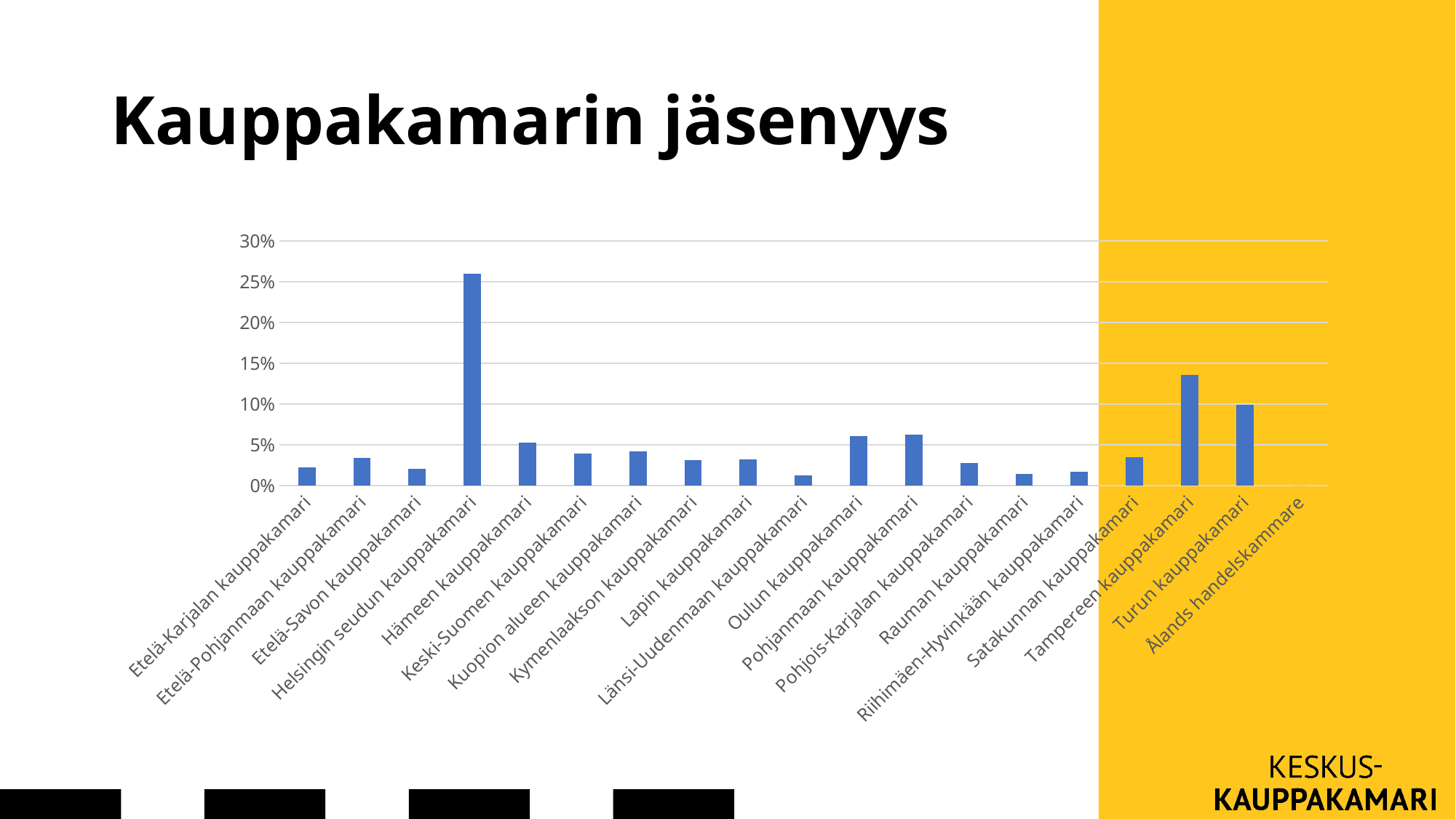
Which is larger, the value for Oulun kauppakamari or Etelä-Savon kauppakamari? Oulun kauppakamari Which is larger, the value for Tampereen kauppakamari or Turun kauppakamari? Tampereen kauppakamari Is the value for Helsingin seudun kauppakamari greater or less than 20%? greater How many categories are shown on the x axis of the chart? 19 Is the value for Etelä-Karjalan kauppakamari greater or less than 5%? less Which category has the highest value in the chart? Helsingin seudun kauppakamari Which category has the lowest value in the chart? Ålands handelskammare Is the value for Tampereen kauppakamari greater or less than 10%? greater What kind of chart is shown on the slide? bar chart What is the highest value shown on the y axis of the chart? 30% What is the title of the slide? Kauppakamarin jäsenyys